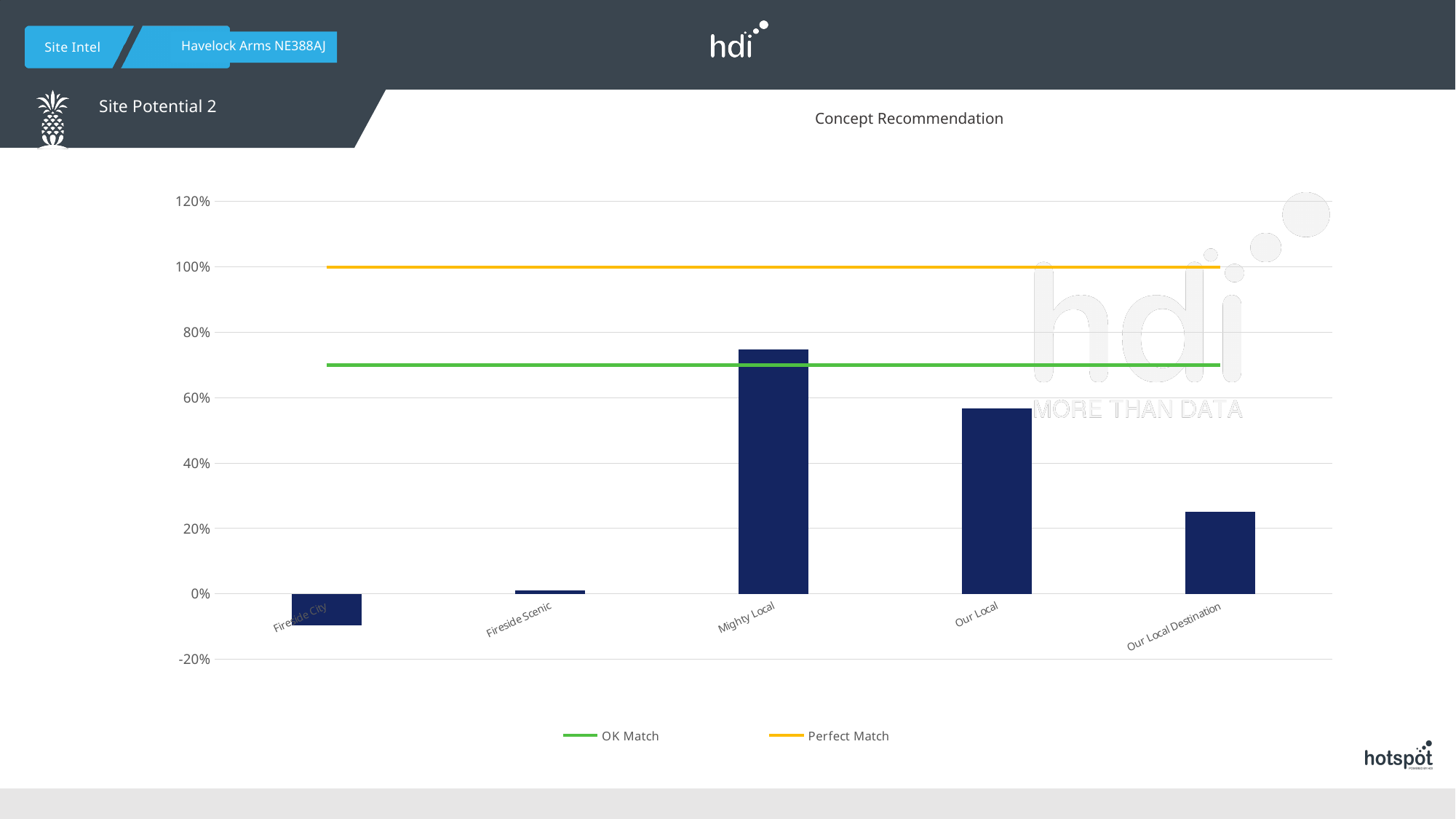
Is the value for Our Local greater or less than 80%? less What kind of chart is shown on the slide? combination bar and line chart How many entries does the legend list? 2 Is the value for Mighty Local greater or less than 60%? greater Which is larger, the value for Our Local or the value for Our Local Destination? Our Local Which concept has the lowest bar? Fireside City Is the value for Fireside City greater or less than 0%? less What is the title of the chart? Concept Recommendation Which concept has the highest bar? Mighty Local How many concept categories are plotted on the x axis? 5 At what level is the Perfect Match line drawn? 100%